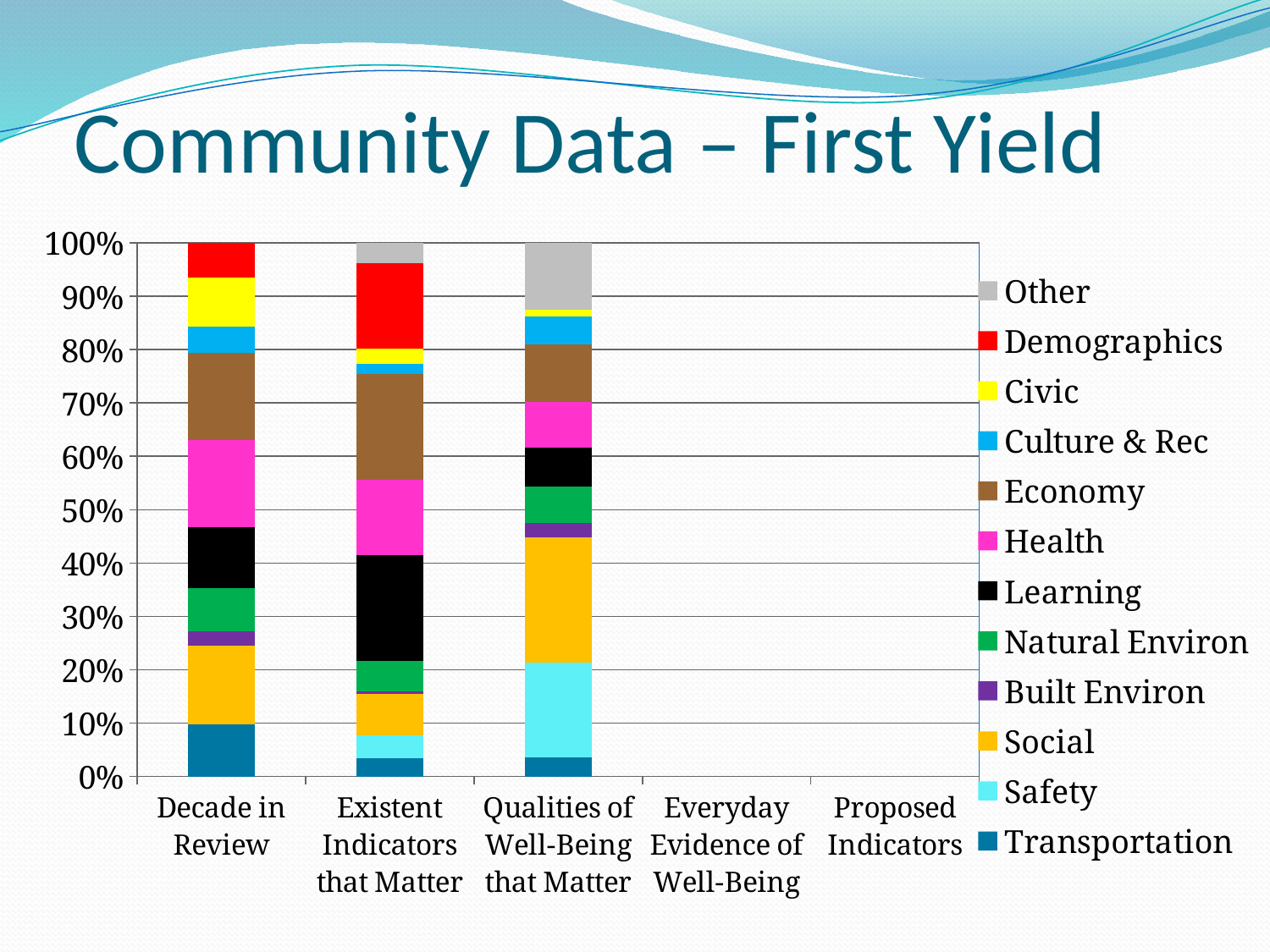
Which categories on the x axis have no bar plotted? Everyday Evidence of Well-Being and Proposed Indicators What kind of chart is shown on the slide? Stacked bar chart Is the Other segment for Qualities of Well-Being that Matter greater or less than 20%? less What is the title of the slide containing the chart? Community Data – First Yield How many categories are labelled along the x axis? 5 Is the Safety segment for Qualities of Well-Being that Matter greater or less than 10%? greater Which category has the largest Safety segment? Qualities of Well-Being that Matter Which is larger: the Social segment for Qualities of Well-Being that Matter or the Social segment for Existent Indicators that Matter? Qualities of Well-Being that Matter How many categories actually have a bar plotted? 3 Is the Demographics segment for Existent Indicators that Matter greater or less than 10%? greater Which is larger: the Learning segment for Existent Indicators that Matter or the Learning segment for Qualities of Well-Being that Matter? Existent Indicators that Matter How many series does the legend list? 12